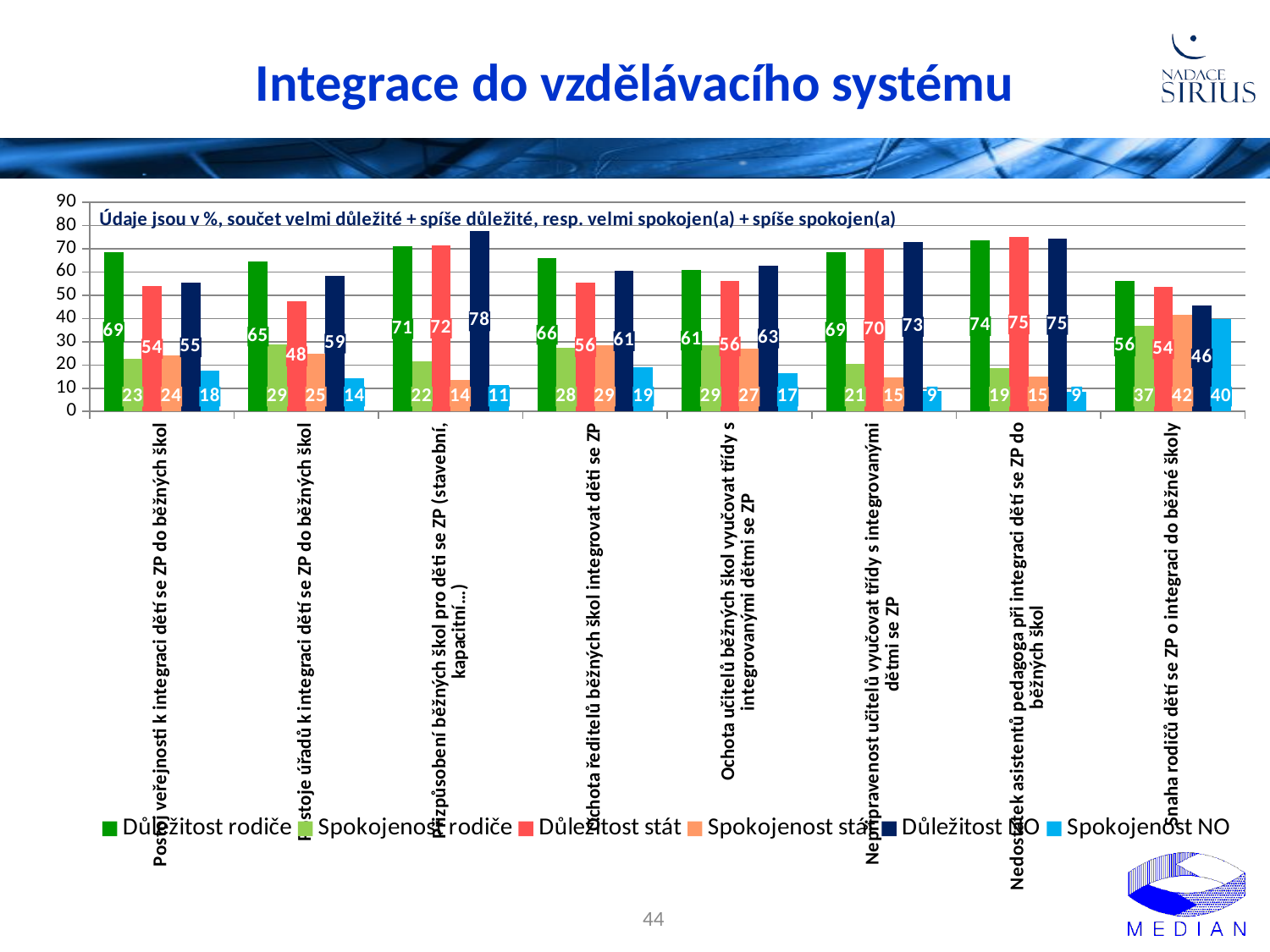
For 'Postoje úřadů k integraci dětí se ZP do běžných škol', which is larger: Důležitost rodiče or Důležitost stát? Důležitost rodiče Which colour represents the Důležitost stát series in the legend? red Is the Důležitost NO value for 'Snaha rodičů dětí se ZP o integraci do běžné školy' greater or less than 50? less What kind of chart is shown on the slide? bar chart What is the value of Důležitost NO for 'Přizpůsobení běžných škol pro děti se ZP (stavební, kapacitní...)'? 78 What is the value of Důležitost rodiče for 'Ochota ředitelů běžných škol integrovat děti se ZP'? 66 How many series does the legend list? 6 What is the difference between Důležitost stát and Spokojenost stát for 'Nedostatek asistentů pedagoga při integraci dětí se ZP do běžných škol'? 60 How many categories are shown on the x axis? 8 Which category has the highest Spokojenost rodiče value? Snaha rodičů dětí se ZP o integraci do běžné školy What is the value of Spokojenost stát for 'Snaha rodičů dětí se ZP o integraci do běžné školy'? 42 Which category has the lowest Spokojenost NO value? Nepřipravenost učitelů vyučovat třídy s integrovanými dětmi se ZP and Nedostatek asistentů pedagoga při integraci dětí se ZP do běžných škol (both 9)